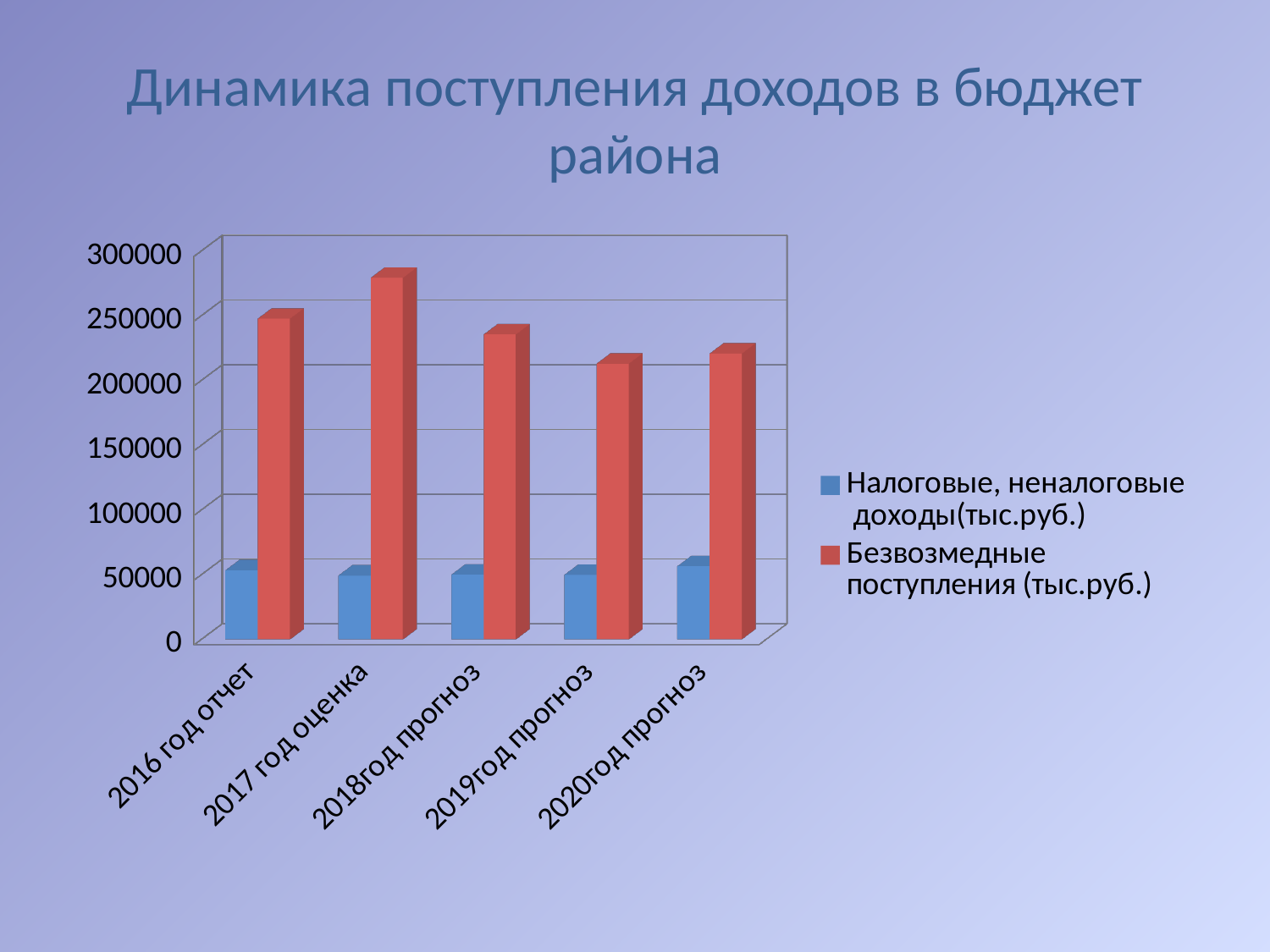
What kind of chart is shown on the slide? bar chart Do the values for Безвозмедные поступления (тыс.руб.) rise or fall from 2017 год оценка to 2019год прогноз? fall Is the value for Безвозмедные поступления (тыс.руб.) in 2017 год оценка greater or less than 250000? greater Which is larger for Безвозмедные поступления (тыс.руб.): 2017 год оценка or 2018год прогноз? 2017 год оценка In 2016 год отчет, which series has the larger value: Налоговые, неналоговые доходы(тыс.руб.) or Безвозмедные поступления (тыс.руб.)? Безвозмедные поступления (тыс.руб.) Is the value for Безвозмедные поступления (тыс.руб.) in 2019год прогноз greater or less than 250000? less Which category has the highest value for Безвозмедные поступления (тыс.руб.)? 2017 год оценка How many series does the legend list? 2 How many categories are shown along the x axis? 5 Is the value for Налоговые, неналоговые доходы(тыс.руб.) in 2016 год отчет greater or less than 100000? less What is the title of the chart? Динамика поступления доходов в бюджет района